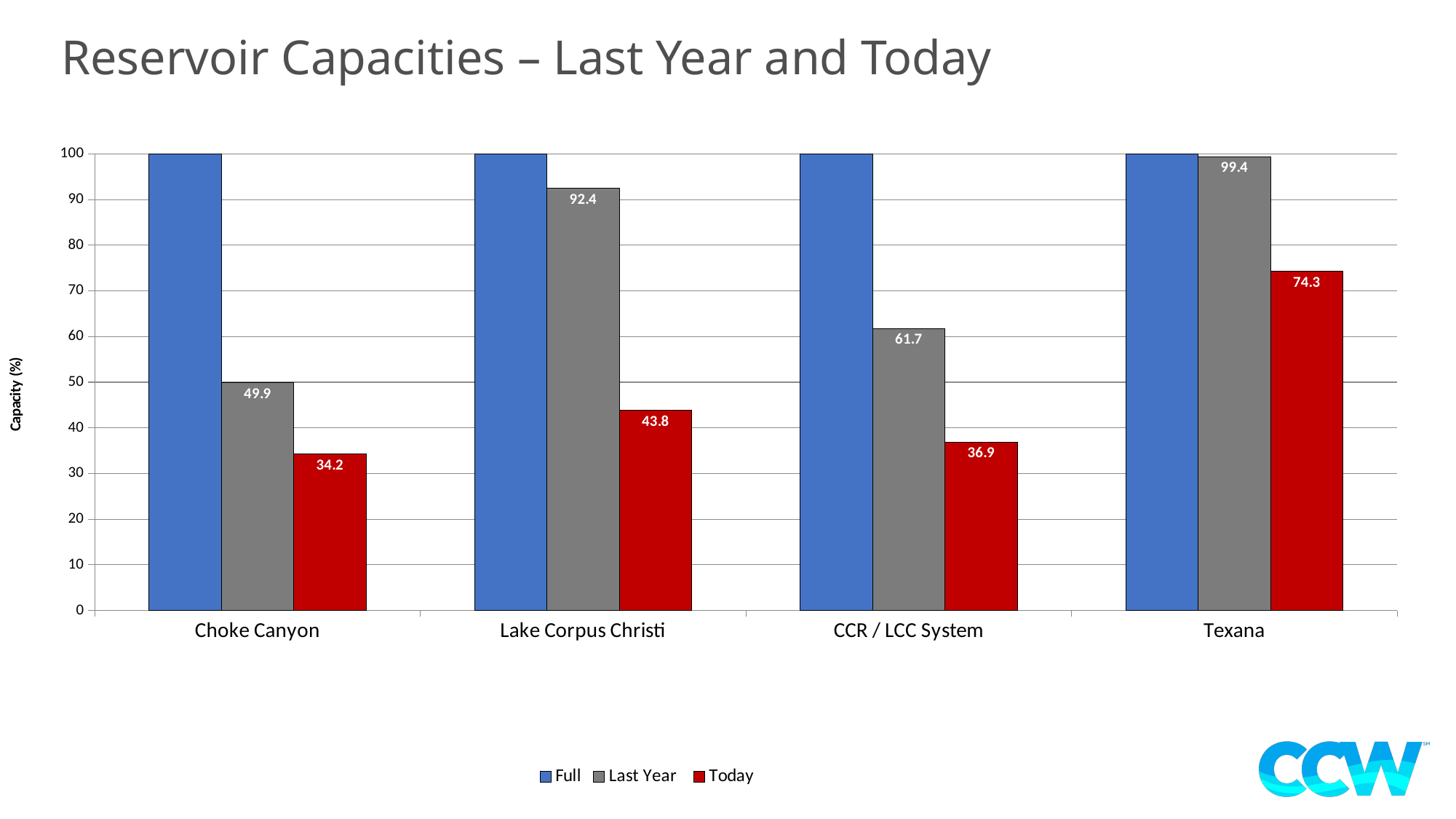
What is the Last Year value for Lake Corpus Christi? 92.4 What kind of chart is shown on the slide? bar chart How many reservoir categories are shown on the x axis? 4 What is the Today value for Texana? 74.3 Which reservoir has the highest Today value? Texana How many series does the legend list? 3 What is the Today value for CCR / LCC System? 36.9 What is the difference between the Last Year and Today values for Lake Corpus Christi? 48.6 Is the Full value for Texana greater or less than 90? greater Is the Today value for Choke Canyon larger or smaller than the Today value for Lake Corpus Christi? smaller Which reservoir has the lowest Last Year value? Choke Canyon What is the Last Year value for Choke Canyon? 49.9